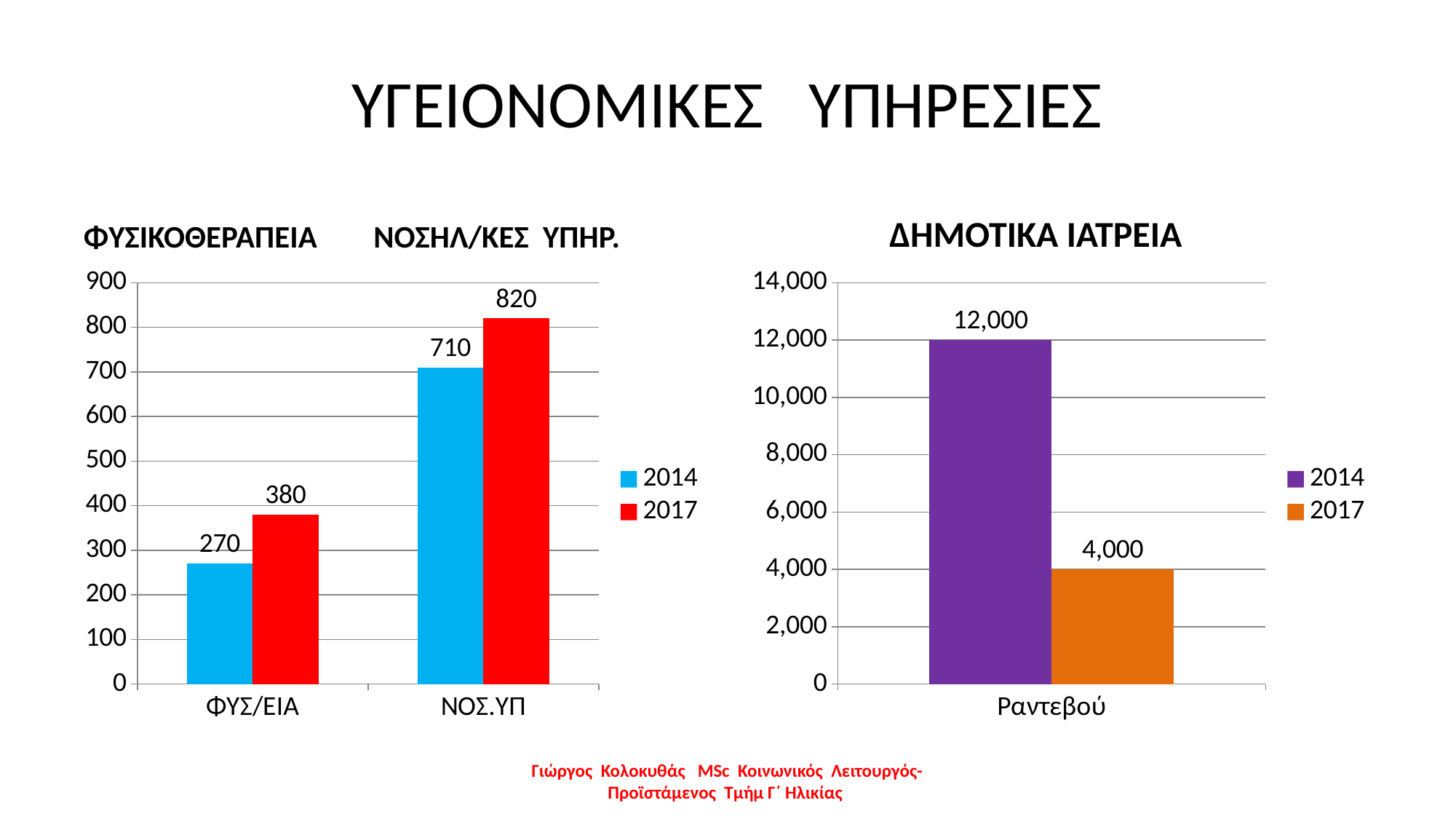
In the left chart (ΦΥΣΙΚΟΘΕΡΑΠΕΙΑ / ΝΟΣΗΛ/ΚΕΣ ΥΠΗΡ.), which category has the highest 2014 value? ΝΟΣ.ΥΠ In the left chart (ΦΥΣΙΚΟΘΕΡΑΠΕΙΑ / ΝΟΣΗΛ/ΚΕΣ ΥΠΗΡ.), what is the difference between the 2017 and 2014 values for ΦΥΣ/ΕΙΑ? 110 In the left chart (ΦΥΣΙΚΟΘΕΡΑΠΕΙΑ / ΝΟΣΗΛ/ΚΕΣ ΥΠΗΡ.), is the 2014 value for ΝΟΣ.ΥΠ greater or less than 700? greater In the left chart (ΦΥΣΙΚΟΘΕΡΑΠΕΙΑ / ΝΟΣΗΛ/ΚΕΣ ΥΠΗΡ.), what is the 2014 value for ΦΥΣ/ΕΙΑ? 270 In the right chart (ΔΗΜΟΤΙΚΑ ΙΑΤΡΕΙΑ), what is the 2017 value for Ραντεβού? 4,000 In the right chart (ΔΗΜΟΤΙΚΑ ΙΑΤΡΕΙΑ), what is the difference between the 2014 and 2017 values for Ραντεβού? 8,000 What kind of chart is the right chart (ΔΗΜΟΤΙΚΑ ΙΑΤΡΕΙΑ)? bar chart In the right chart (ΔΗΜΟΤΙΚΑ ΙΑΤΡΕΙΑ), what is the 2014 value for Ραντεβού? 12,000 In the left chart (ΦΥΣΙΚΟΘΕΡΑΠΕΙΑ / ΝΟΣΗΛ/ΚΕΣ ΥΠΗΡ.), how many series does the legend list? 2 In the right chart (ΔΗΜΟΤΙΚΑ ΙΑΤΡΕΙΑ), which series has the larger value for Ραντεβού, 2014 or 2017? 2014 In the left chart (ΦΥΣΙΚΟΘΕΡΑΠΕΙΑ / ΝΟΣΗΛ/ΚΕΣ ΥΠΗΡ.), how many categories are shown on the x axis? 2 In the left chart (ΦΥΣΙΚΟΘΕΡΑΠΕΙΑ / ΝΟΣΗΛ/ΚΕΣ ΥΠΗΡ.), what is the 2017 value for ΝΟΣ.ΥΠ? 820